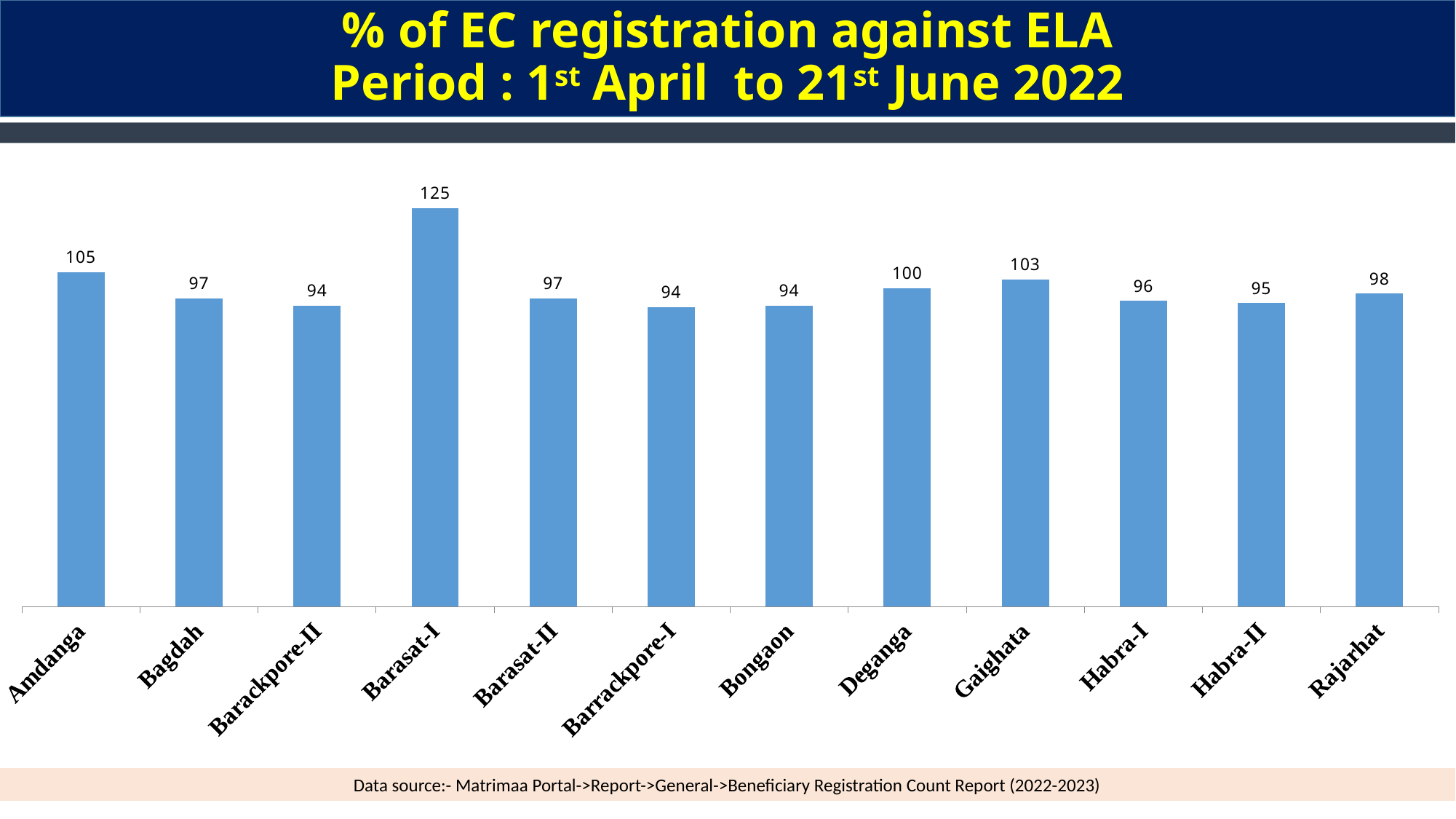
What is the title of the chart? % of EC registration against ELA Period : 1st April to 21st June 2022 What is the value for Amdanga? 105 How many blocks are shown on the x axis? 12 Which is larger, the value for Amdanga or the value for Gaighata? Amdanga What is the difference between the values for Barasat-I and Amdanga? 20 What is the value for Habra-II? 95 What kind of chart is shown on the slide? Bar chart What is the value for Deganga? 100 What is the difference between the values for Gaighata and Bagdah? 6 Which block has the highest value? Barasat-I Which is larger, the value for Deganga or the value for Rajarhat? Deganga What is the value for Barasat-I? 125